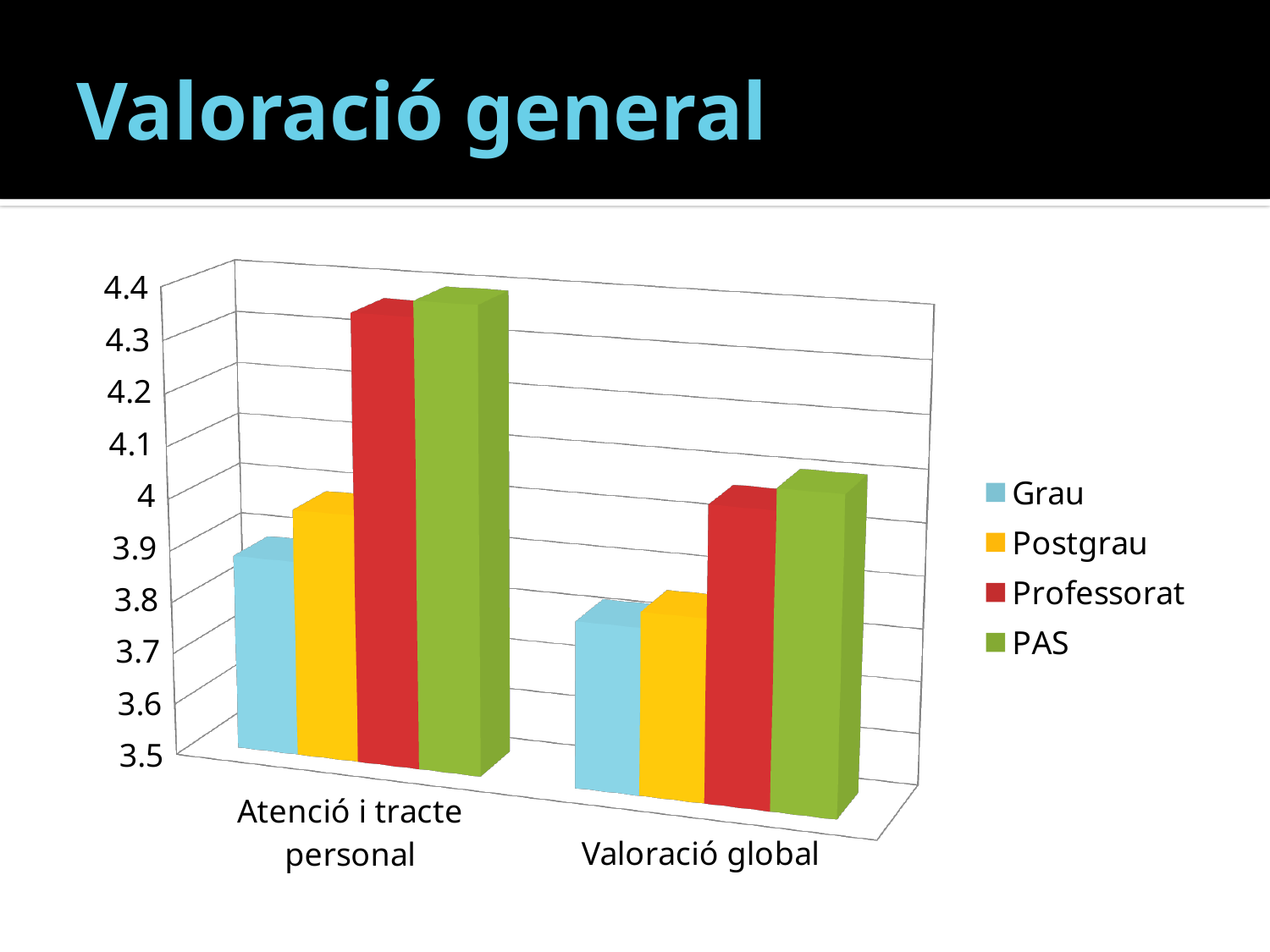
What is the title of the slide containing the chart? Valoració general How many categories are shown on the x axis? 2 Is the value for Professorat in 'Atenció i tracte personal' greater or less than 4.2? greater Which series has the lowest value in 'Atenció i tracte personal'? Grau Which is larger in 'Atenció i tracte personal': the value for Professorat or the value for Grau? Professorat Is the value for Grau in 'Valoració global' greater or less than 3.9? less Do the values for Professorat rise or fall from 'Atenció i tracte personal' to 'Valoració global'? fall Is the value for PAS in 'Valoració global' greater or less than 3.8? greater How many series does the legend list? 4 Which series is shown in red in the legend? Professorat What kind of chart is shown on the slide? bar chart